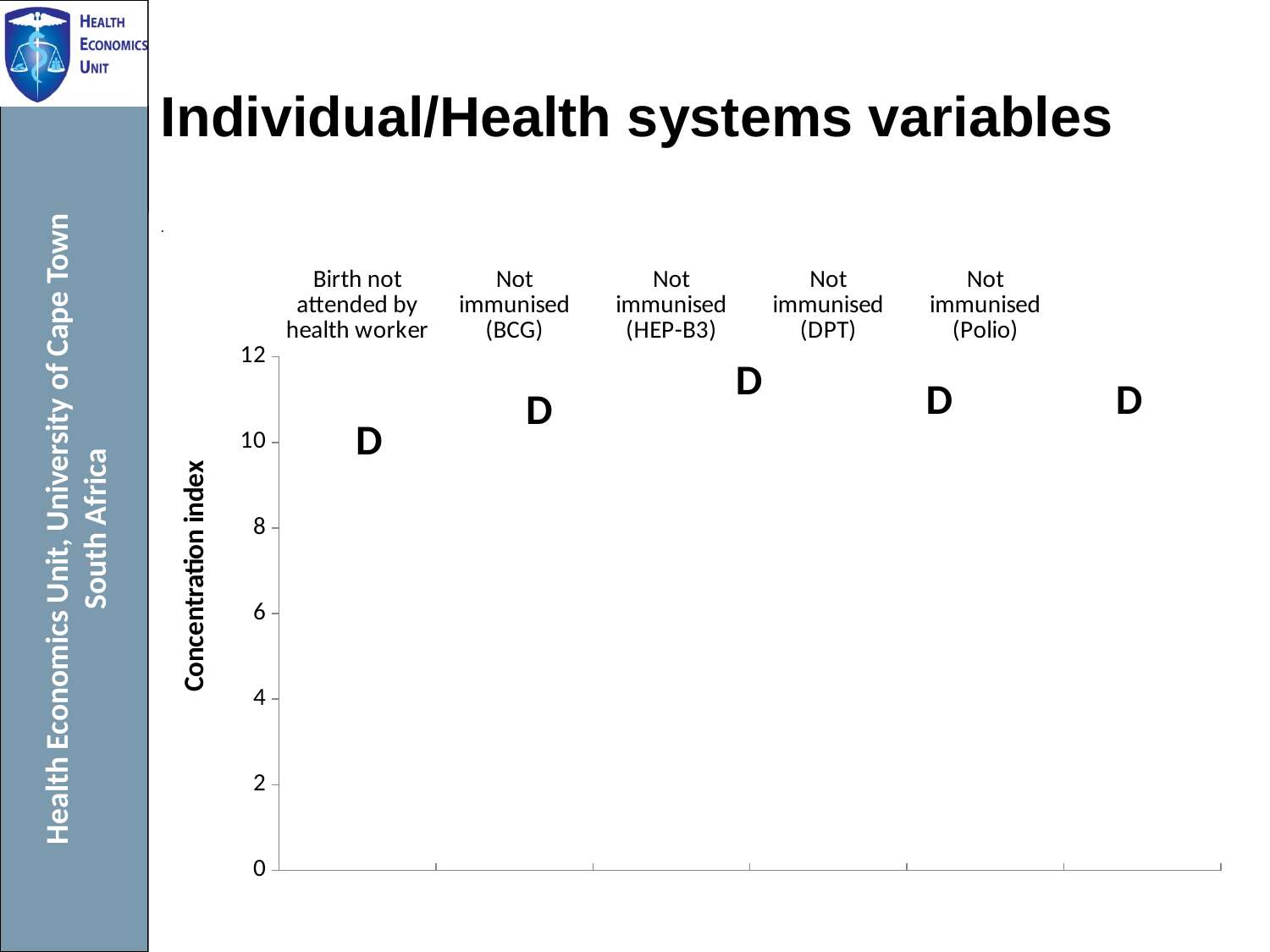
Which is larger, the value for Birth not attended by health worker or the value for Not immunised (DPT)? Not immunised (DPT) Which is larger, the value for Birth not attended by health worker or the value for Not immunised (HEP-B3)? Not immunised (HEP-B3) What is the title shown above the chart? Individual/Health systems variables How many categories are plotted on the chart? 5 What is the highest value shown on the vertical axis of the chart? 12 What is the label of the vertical axis of the chart? Concentration index Which category has the lowest concentration index on the chart? Birth not attended by health worker